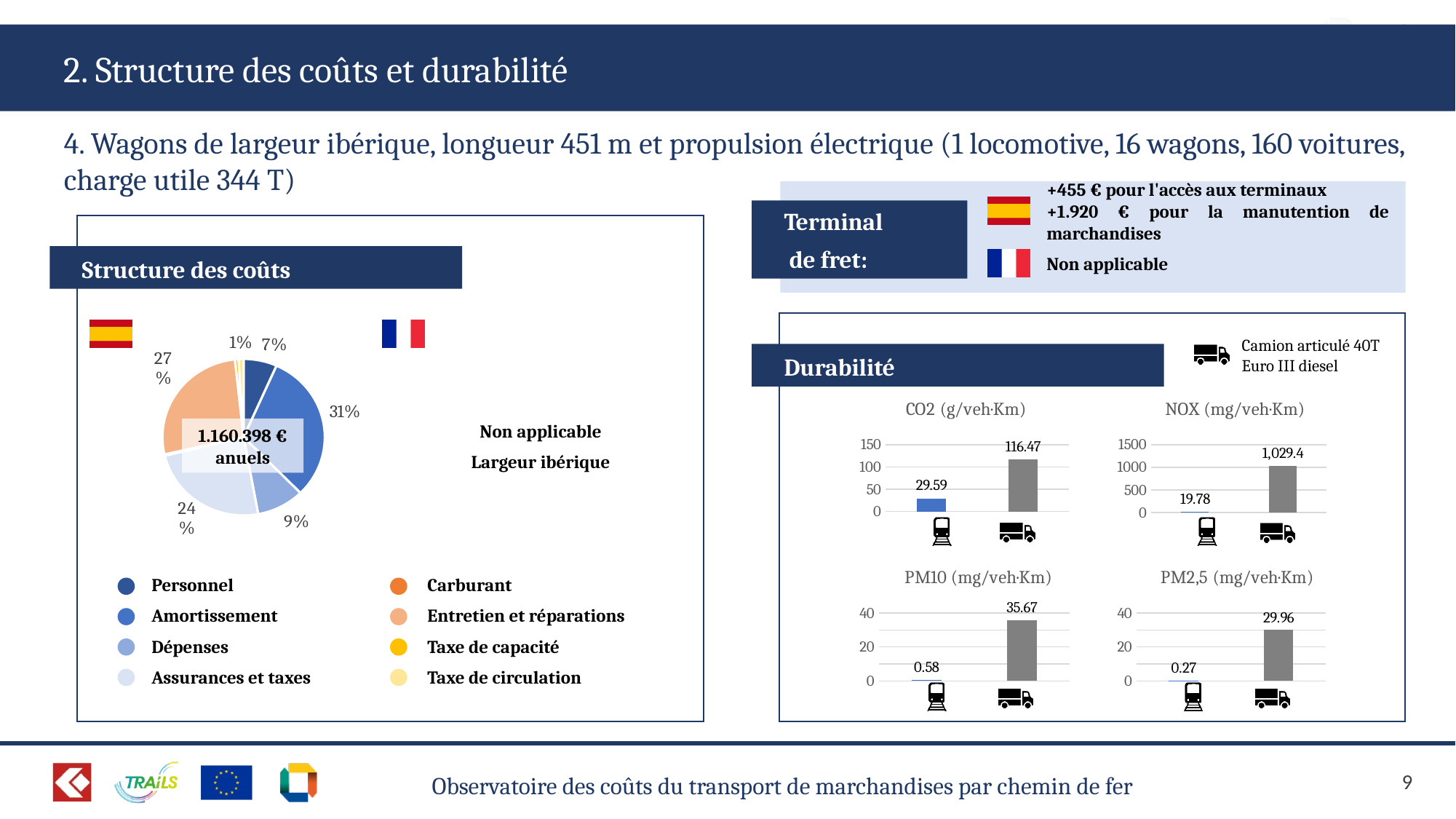
In the Structure des coûts pie chart, what share does the largest slice represent? 31% In the PM2,5 (mg/veh·Km) chart, is the value for the truck greater or less than 20? greater In the CO2 (g/veh·Km) chart, what is the difference between the truck value and the train value? 86.88 What kind of chart is used for the Structure des coûts? Pie chart How many entries does the legend of the Structure des coûts pie chart list? 8 In the PM2,5 (mg/veh·Km) chart, what is the value for the truck? 29.96 In the PM10 (mg/veh·Km) chart, what is the value for the train? 0.58 In the NOX (mg/veh·Km) chart, which has the higher value, the train or the truck? Truck In the PM10 (mg/veh·Km) chart, what is the difference between the truck value and the train value? 35.09 In the CO2 (g/veh·Km) chart, what is the value for the truck? 116.47 In the NOX (mg/veh·Km) chart, what is the value for the truck? 1,029.4 In the CO2 (g/veh·Km) chart, what is the value for the train? 29.59